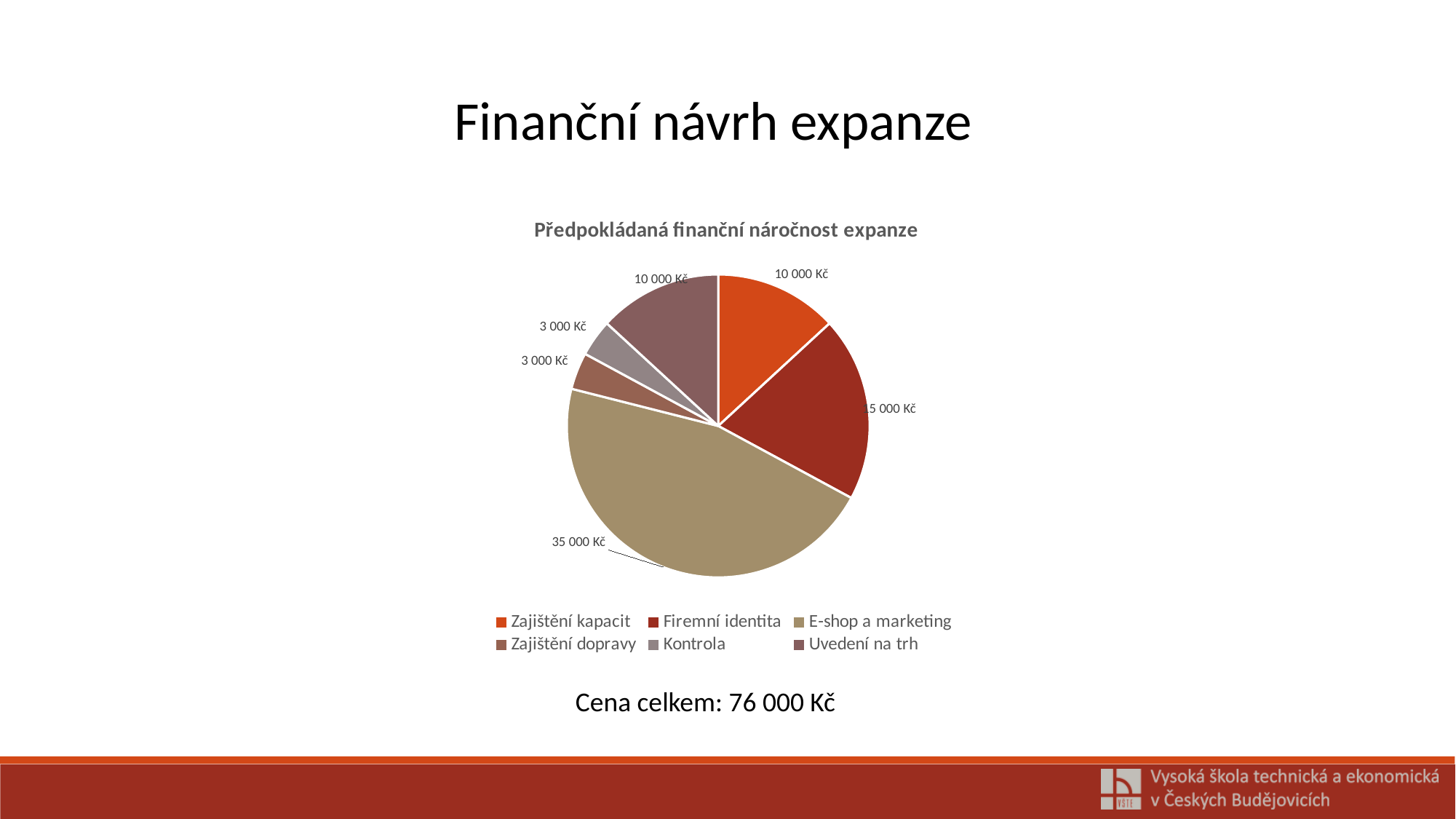
What is the value for E-shop a marketing? 35 000 Kč Which category has the largest slice of the pie? E-shop a marketing What is the title of the chart? Předpokládaná finanční náročnost expanze What is the difference between the values for E-shop a marketing and Firemní identita? 20 000 Kč How many categories does the pie chart have? 6 Which is larger, the value for Firemní identita or the value for Zajištění kapacit? Firemní identita What total cost is stated below the chart? 76 000 Kč What type of chart is shown on the slide? pie chart What is the value for Kontrola? 3 000 Kč What is the value for Zajištění kapacit? 10 000 Kč What is the value for Firemní identita? 15 000 Kč What is the value for Uvedení na trh? 10 000 Kč